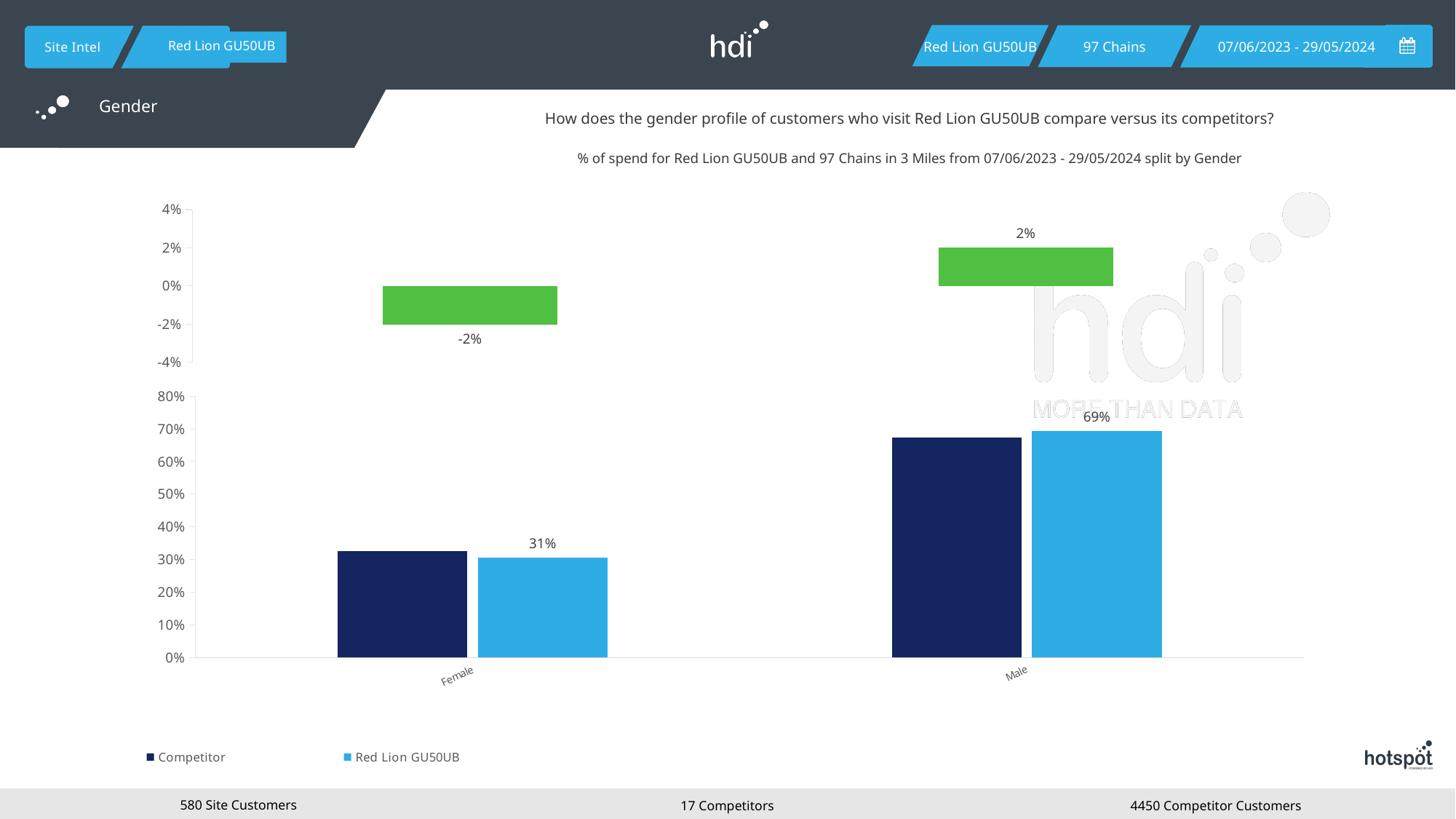
In the bottom bar chart, is the Competitor value for Female greater or less than 40%? less In the bottom bar chart, which category has the highest value for Red Lion GU50UB? Male In the top chart with green bars, what is the value shown for Female? -2% What kind of chart is the bottom chart on the slide? Bar chart In the bottom bar chart, is the Competitor value for Male greater or less than 60%? greater In the bottom bar chart, what is the difference between the Red Lion GU50UB values for Male and Female? 38% In the bottom bar chart, what is the value for Red Lion GU50UB in the Female category? 31% In the top chart with green bars, what is the value shown for Male? 2% In the bottom bar chart, which category has the lowest value for Red Lion GU50UB? Female In the bottom bar chart, what is the value for Red Lion GU50UB in the Male category? 69% How many categories are shown on the x axis of the bottom bar chart? 2 How many series does the legend of the bottom bar chart list? 2